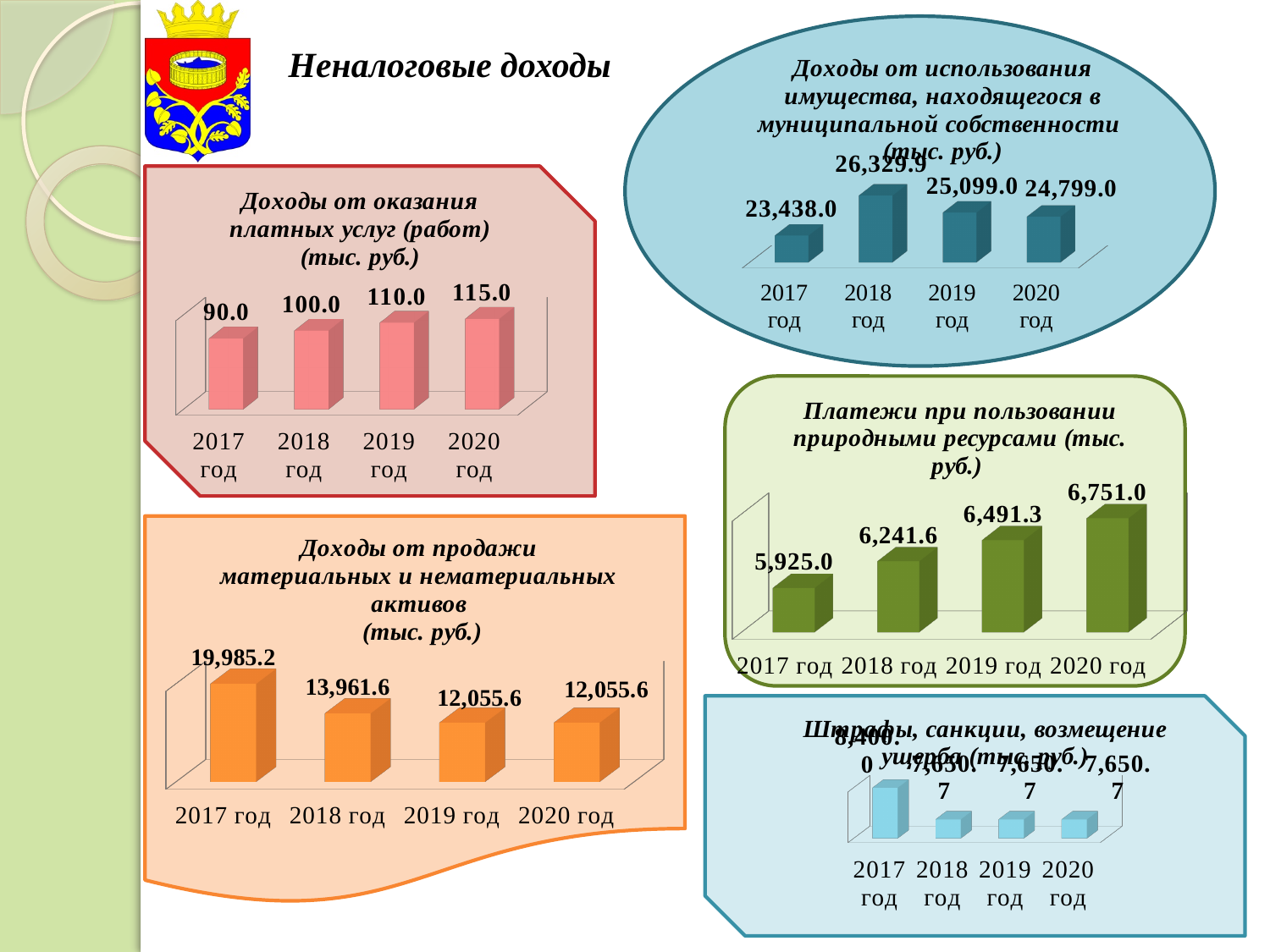
In the chart 'Платежи при пользовании природными ресурсами', which year has the lowest value? 2017 год How many bar charts are shown on the slide? 5 In the chart 'Доходы от продажи материальных и нематериальных активов', what is the value for 2017 год? 19,985.2 In the chart 'Доходы от продажи материальных и нематериальных активов', which is larger: the value for 2018 год or 2019 год? 2018 год In the chart 'Доходы от использования имущества, находящегося в муниципальной собственности', what is the difference between the 2019 and 2020 values? 300.0 In the chart 'Платежи при пользовании природными ресурсами', what is the value for 2018 год? 6,241.6 In the chart 'Штрафы, санкции, возмещение ущерба', which year has the highest bar? 2017 год In the chart 'Доходы от продажи материальных и нематериальных активов', what is the difference between the 2017 and 2018 values? 6,023.6 In the chart 'Доходы от оказания платных услуг (работ)', do the values rise or fall from 2017 to 2020? rise In the chart 'Доходы от оказания платных услуг (работ)', what is the value for 2020 год? 115.0 In the chart 'Доходы от использования имущества, находящегося в муниципальной собственности', which year has the highest value? 2018 год In the chart 'Доходы от использования имущества, находящегося в муниципальной собственности', what is the value for 2017 год? 23,438.0